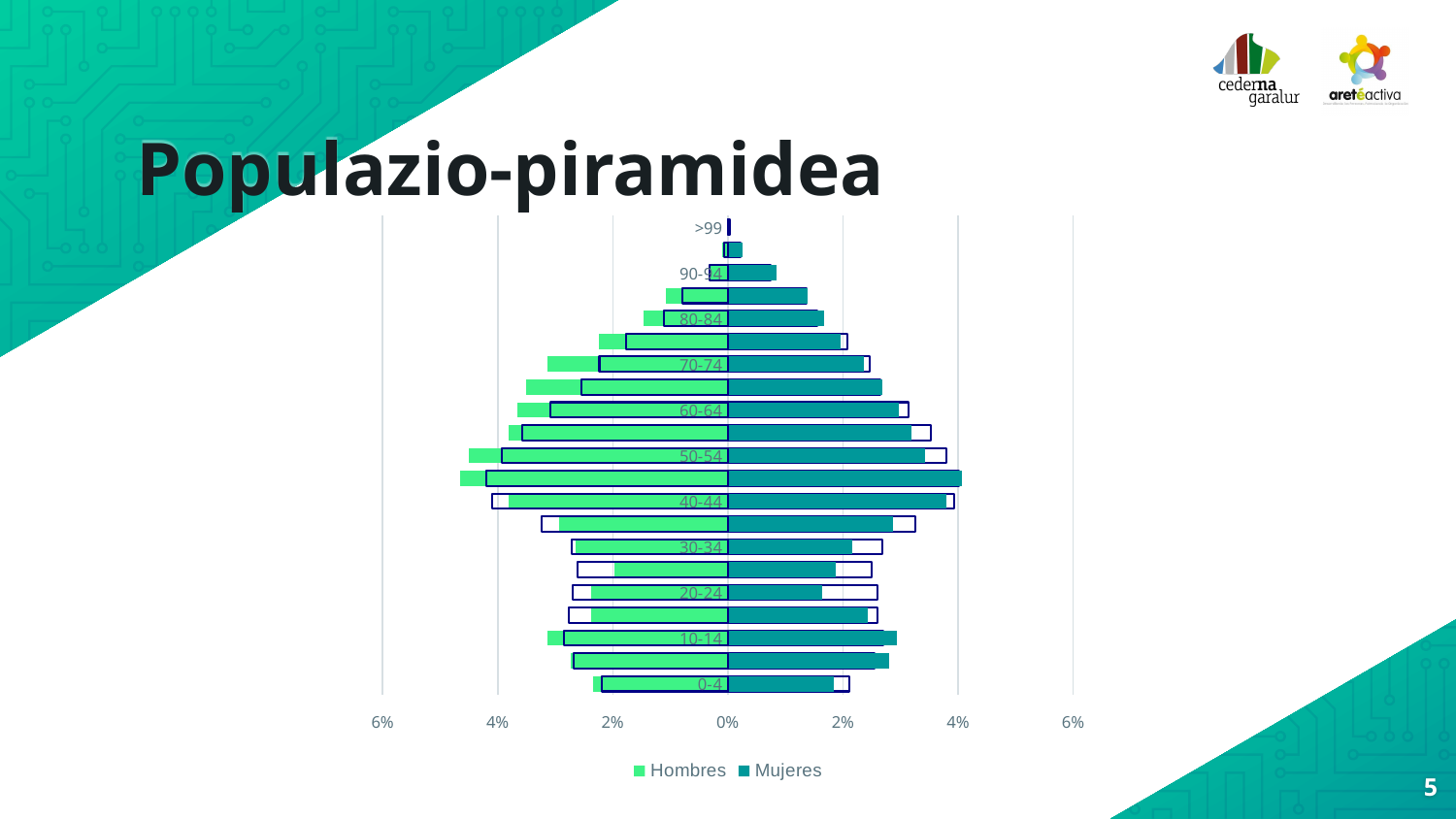
Is the Hombres value for the 70-74 age group greater or less than 2%? greater What is the title of the slide containing the chart? Populazio-piramidea How many age groups are plotted in the chart? 21 Is the Mujeres value for the 90-94 age group greater or less than 2%? less Is the Hombres value for the 50-54 age group greater or less than 4%? greater How many series does the legend list? 2 Which series has the larger value for the 50-54 age group, Hombres or Mujeres? Hombres Which age group has the lowest Mujeres value? >99 What kind of chart is shown on the slide? bar chart Which series has the larger value for the 90-94 age group, Hombres or Mujeres? Mujeres What are the two series named in the legend? Hombres and Mujeres